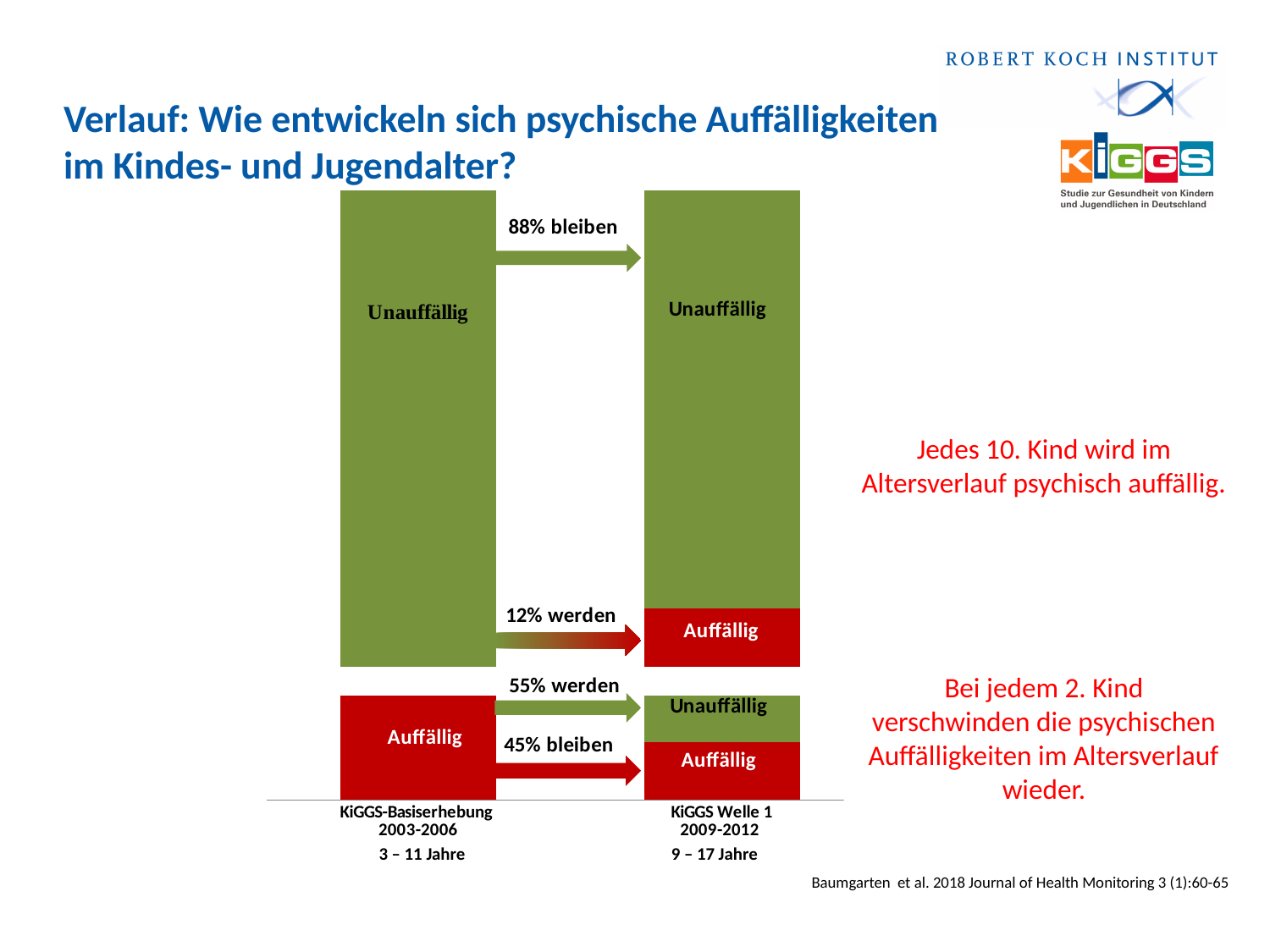
What is the total of the two transition shares starting from the 'Unauffällig' group (88% and 12%)? 100% What percentage of children who were 'Unauffällig' in the KiGGS-Basiserhebung remain 'Unauffällig' in KiGGS Welle 1? 88% What is the difference between the share of 'Unauffällig' children who remain 'Unauffällig' (88%) and the share who become 'Auffällig' (12%)? 76% What is the difference between the share of 'Auffällig' children who become 'Unauffällig' (55%) and the share who remain 'Auffällig' (45%)? 10% Of the children who were 'Auffällig' at baseline, is the share that becomes 'Unauffällig' larger or smaller than the share that stays 'Auffällig'? larger What percentage of children who were 'Auffällig' in the KiGGS-Basiserhebung become 'Unauffällig' in KiGGS Welle 1? 55% Which transition from the 'Unauffällig' group has the larger share: '88% bleiben' or '12% werden'? 88% bleiben What percentage of children who were 'Auffällig' in the KiGGS-Basiserhebung remain 'Auffällig' in KiGGS Welle 1? 45% How many survey waves (bars) are shown on the x axis of the chart? 2 Which colour is used for the 'Auffällig' segments in the chart? Red What percentage of children who were 'Unauffällig' in the KiGGS-Basiserhebung become 'Auffällig' in KiGGS Welle 1? 12% What age range is given for the KiGGS Welle 1 2009-2012 bar? 9 – 17 Jahre